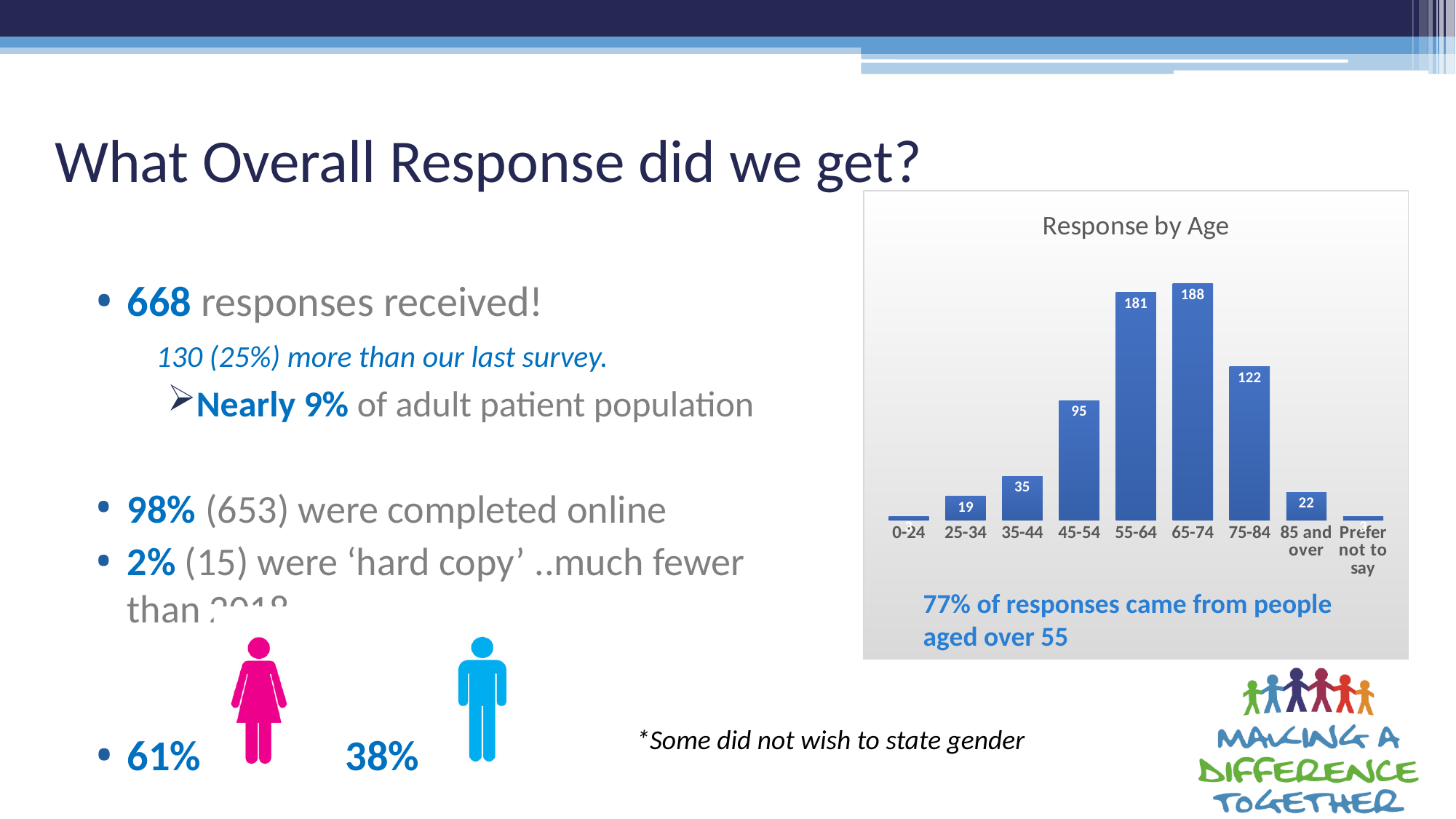
What is the value for the 45-54 age group in the Response by Age chart? 95 What is the value for the 85 and over age group in the Response by Age chart? 22 What is the difference between the values for the 65-74 and 55-64 age groups in the Response by Age chart? 7 Which has a larger value in the Response by Age chart, the 75-84 group or the 45-54 group? 75-84 In the Response by Age chart, do the values rise or fall from the 65-74 group to the 85 and over group? fall How many age categories are shown on the x axis of the Response by Age chart? 9 What is the value for the 25-34 age group in the Response by Age chart? 19 Which age group has the highest number of responses in the Response by Age chart? 65-74 What is the value for the 55-64 age group in the Response by Age chart? 181 What is the title of the chart on the slide? Response by Age What kind of chart is shown on the slide? bar chart What is the value for the 65-74 age group in the Response by Age chart? 188